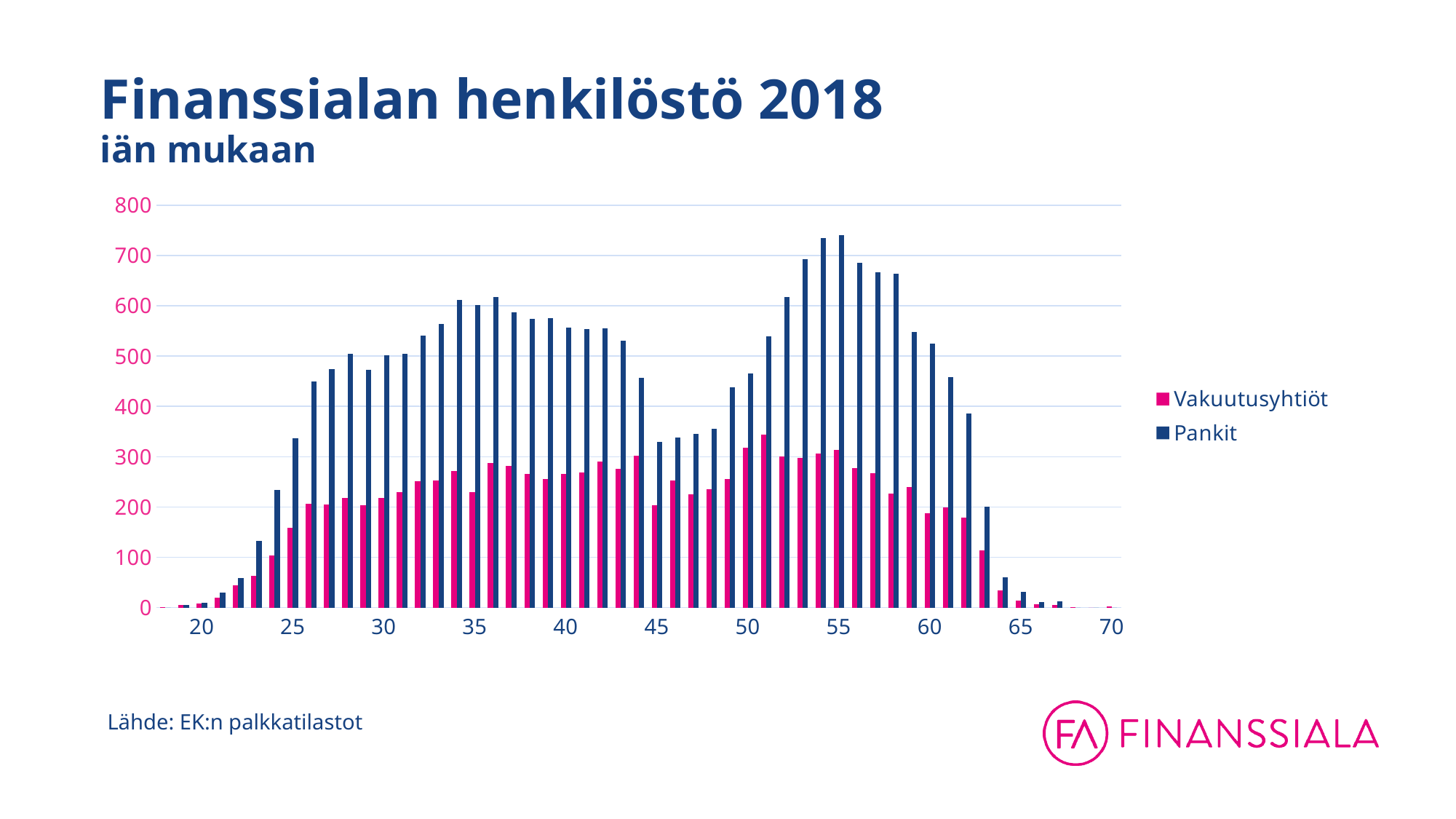
Which series has the larger value at age 55, Vakuutusyhtiöt or Pankit? Pankit Is the Pankit value for age 50 greater or less than 500? less Which age has the highest Vakuutusyhtiöt value? 51 Is the Vakuutusyhtiöt value for age 51 greater or less than 300? greater Is the Pankit value for age 55 greater or less than 700? greater How many series does the legend list? 2 What is the title of the chart? Finanssialan henkilöstö 2018 iän mukaan Do the Pankit values rise or fall from age 20 to age 25? rise Do the Pankit values rise or fall from age 55 to age 65? fall What kind of chart is shown on the slide? bar chart